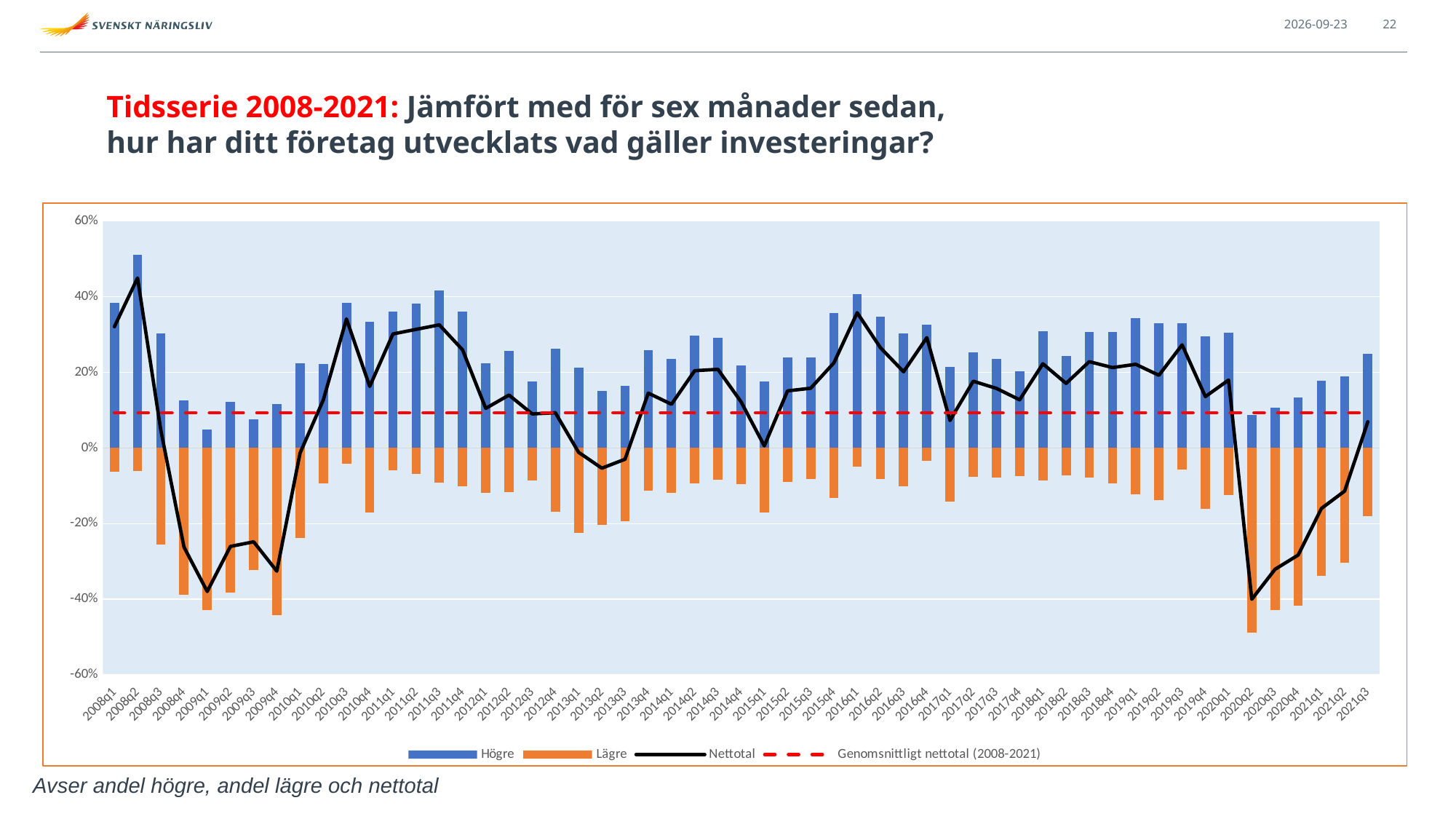
What does the red dashed line represent according to the legend? Genomsnittligt nettotal (2008-2021) Is the Lägre value for 2020q2 greater or less than -40%? less Is the Högre value for 2008q2 greater or less than 40%? greater What kind of chart is shown on the slide? Bar chart with line series In which quarter does the Nettotal line reach its highest point? 2008q2 In which quarter is the Högre bar highest? 2008q2 How many series does the legend list? 4 Is the Nettotal value for 2009q1 greater or less than -20%? less Which quarter has the larger Högre bar, 2008q2 or 2008q3? 2008q2 How many quarters are plotted on the x axis, from 2008q1 to 2021q3? 55 In which quarter does the Lägre bar reach furthest below zero? 2020q2 Does the Nettotal line rise or fall from 2020q2 to 2021q3? rise